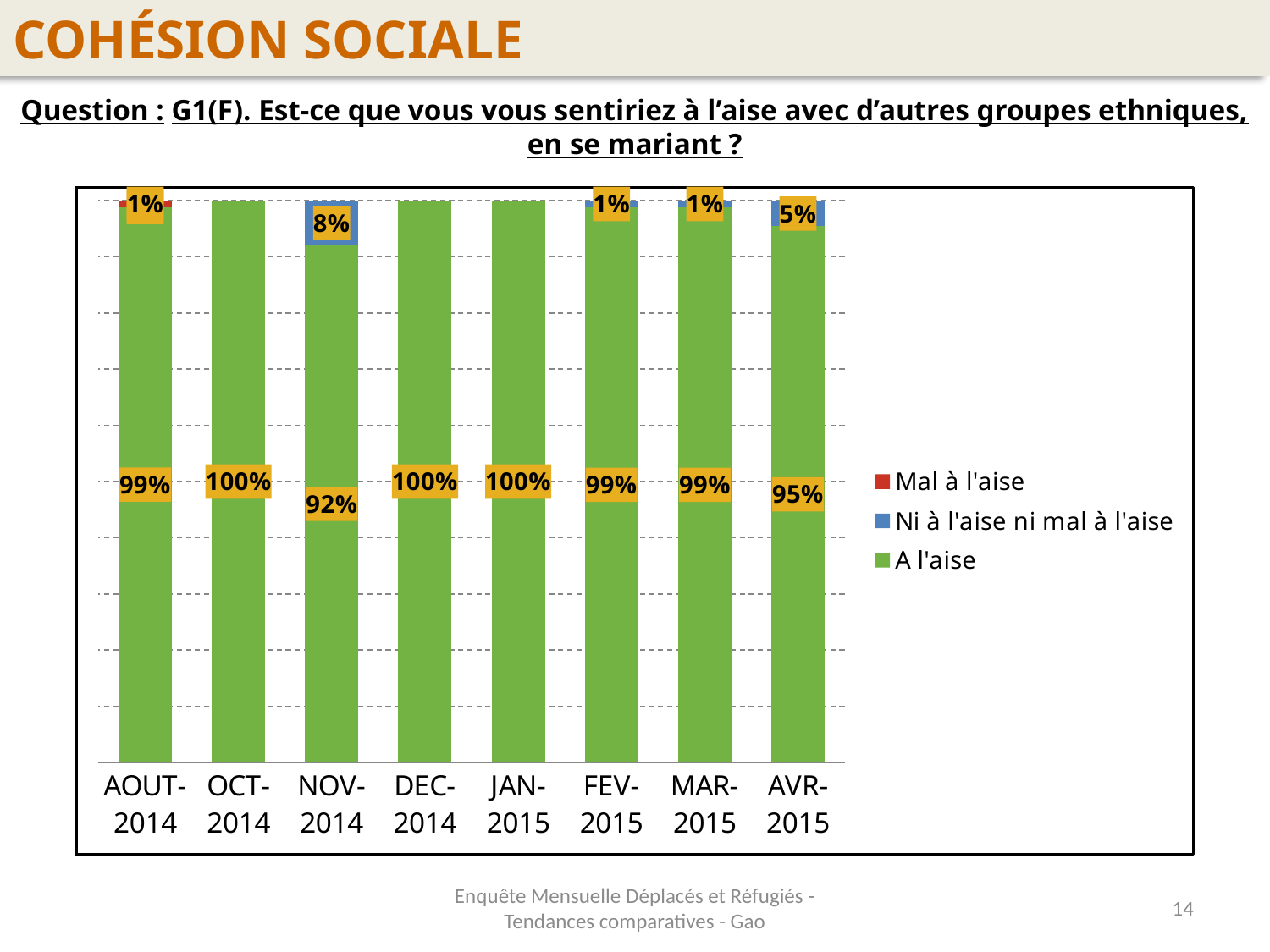
How many months are shown on the x axis? 8 Which is larger, the "A l'aise" value for AVR-2015 or for NOV-2014? AVR-2015 What is the value for "Ni à l'aise ni mal à l'aise" in AVR-2015? 5% What is the value for "Ni à l'aise ni mal à l'aise" in NOV-2014? 8% What is the value for "A l'aise" in NOV-2014? 92% Which legend entry is shown in green? A l'aise What kind of chart is shown on the slide? Stacked bar chart What is the value for "A l'aise" in AOUT-2014? 99% What is the value for "A l'aise" in AVR-2015? 95% Which month has the lowest value for "A l'aise"? NOV-2014 How many series does the legend list? 3 What is the difference between the "A l'aise" values for DEC-2014 and NOV-2014? 8%